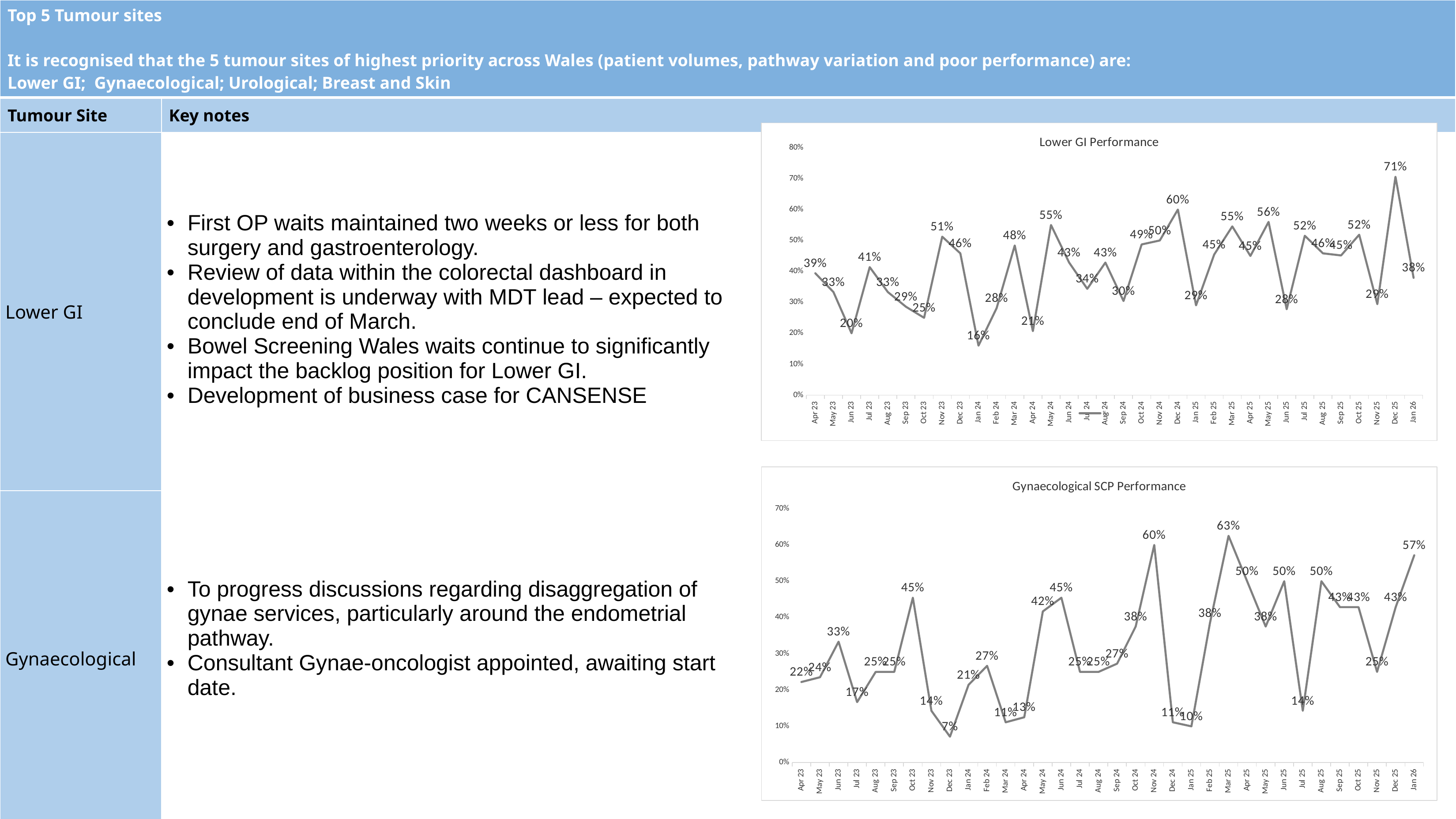
What kind of chart is the Lower GI Performance chart? Line chart In the Lower GI Performance chart, what is the difference between the values for Dec 24 and Jan 25? 31% In the Lower GI Performance chart, what is the value for Dec 25? 71% In the Gynaecological SCP Performance chart, which is larger, the value for Nov 24 or the value for Jan 26? Nov 24 In the Lower GI Performance chart, what is the value for Apr 23? 39% In the Lower GI Performance chart, what is the value for Jan 26? 38% In the Gynaecological SCP Performance chart, which month has the highest value? Mar 25 In the Lower GI Performance chart, which month has the lowest value? Jan 24 In the Gynaecological SCP Performance chart, what is the difference between the values for Jan 26 and Nov 25? 32% What is the title of the lower chart on the slide? Gynaecological SCP Performance How many monthly data points are plotted in the Gynaecological SCP Performance chart? 34 In the Gynaecological SCP Performance chart, what is the value for Dec 23? 7%